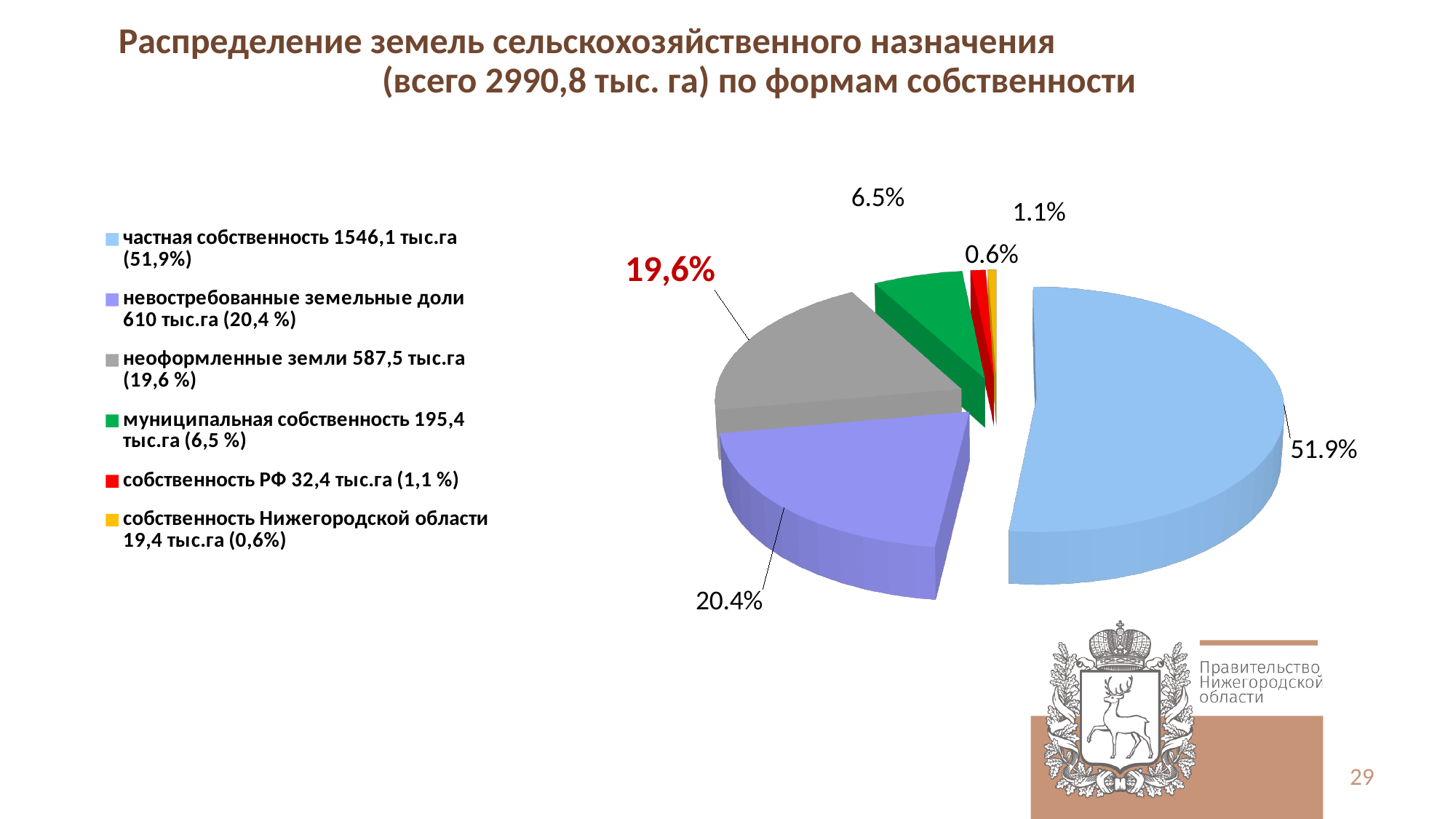
What is the difference in area between частная собственность (1546,1 тыс.га) and невостребованные земельные доли (610 тыс.га)? 936,1 тыс.га What percentage share of the pie is labelled for неоформленные земли? 19,6% What total area of agricultural land is stated in the chart title? 2990,8 тыс. га Which is larger: the area of невостребованные земельные доли or the area of неоформленные земли? невостребованные земельные доли What percentage share of the pie is labelled for невостребованные земельные доли? 20.4% Which form of ownership has the largest share of agricultural land? частная собственность What area (тыс.га) is listed for муниципальная собственность? 195,4 тыс.га What area (тыс.га) is listed for частная собственность? 1546,1 тыс.га What is the difference in area between собственность РФ (32,4 тыс.га) and собственность Нижегородской области (19,4 тыс.га)? 13 тыс.га Which form of ownership has the smallest share of agricultural land? собственность Нижегородской области What kind of chart is shown on the slide? pie chart How many slices does the pie chart have? 6